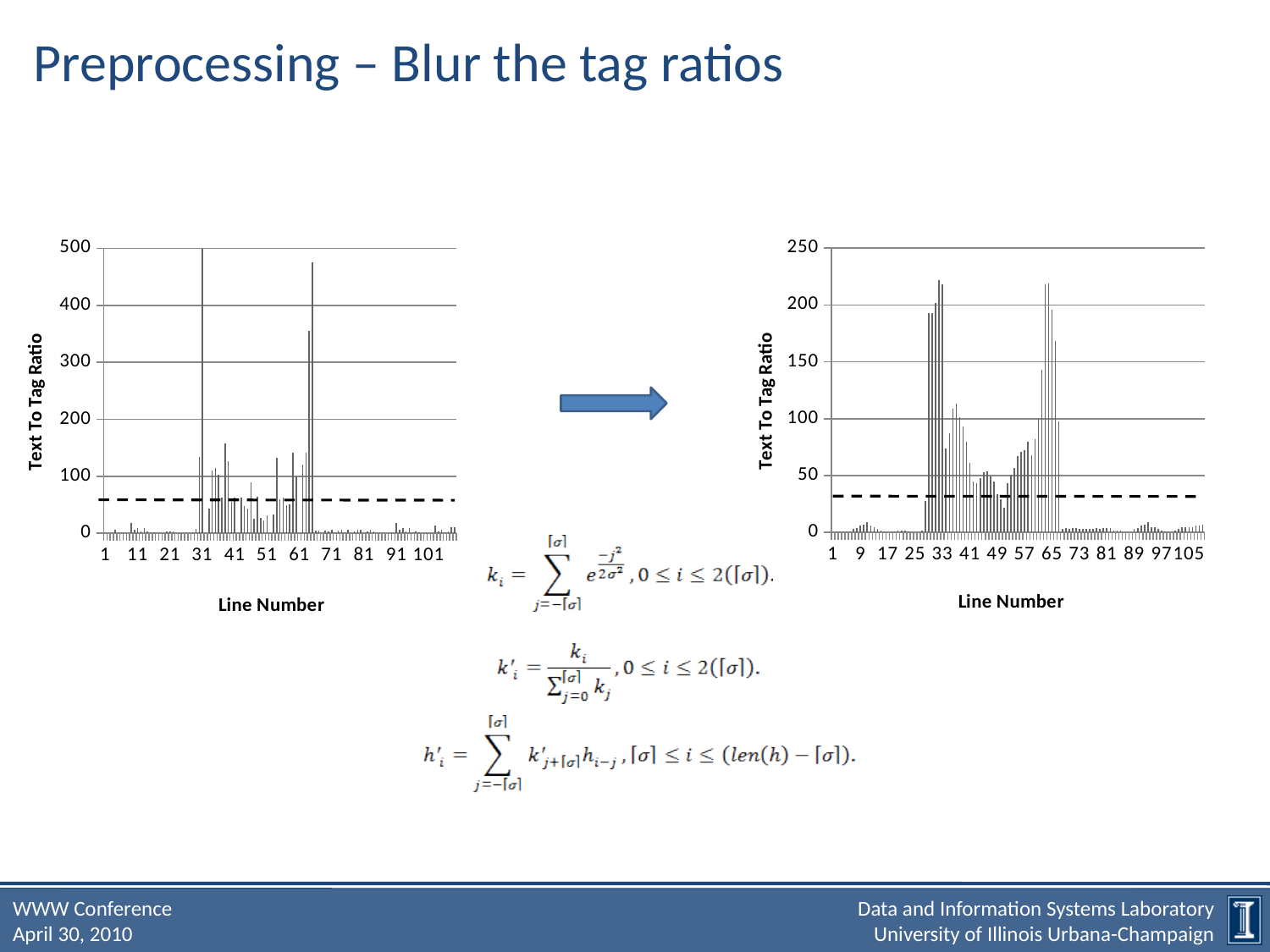
What kind of chart is the left chart on the slide? bar chart In the right chart, is the value for line 1 greater or less than 50? less What is the y-axis title of the left chart? Text To Tag Ratio In the left chart, is the value for line 1 greater or less than 100? less In the right chart, is the value for line 81 greater or less than 50? less What kind of chart is the right chart on the slide? bar chart What is the x-axis title of the right chart? Line Number